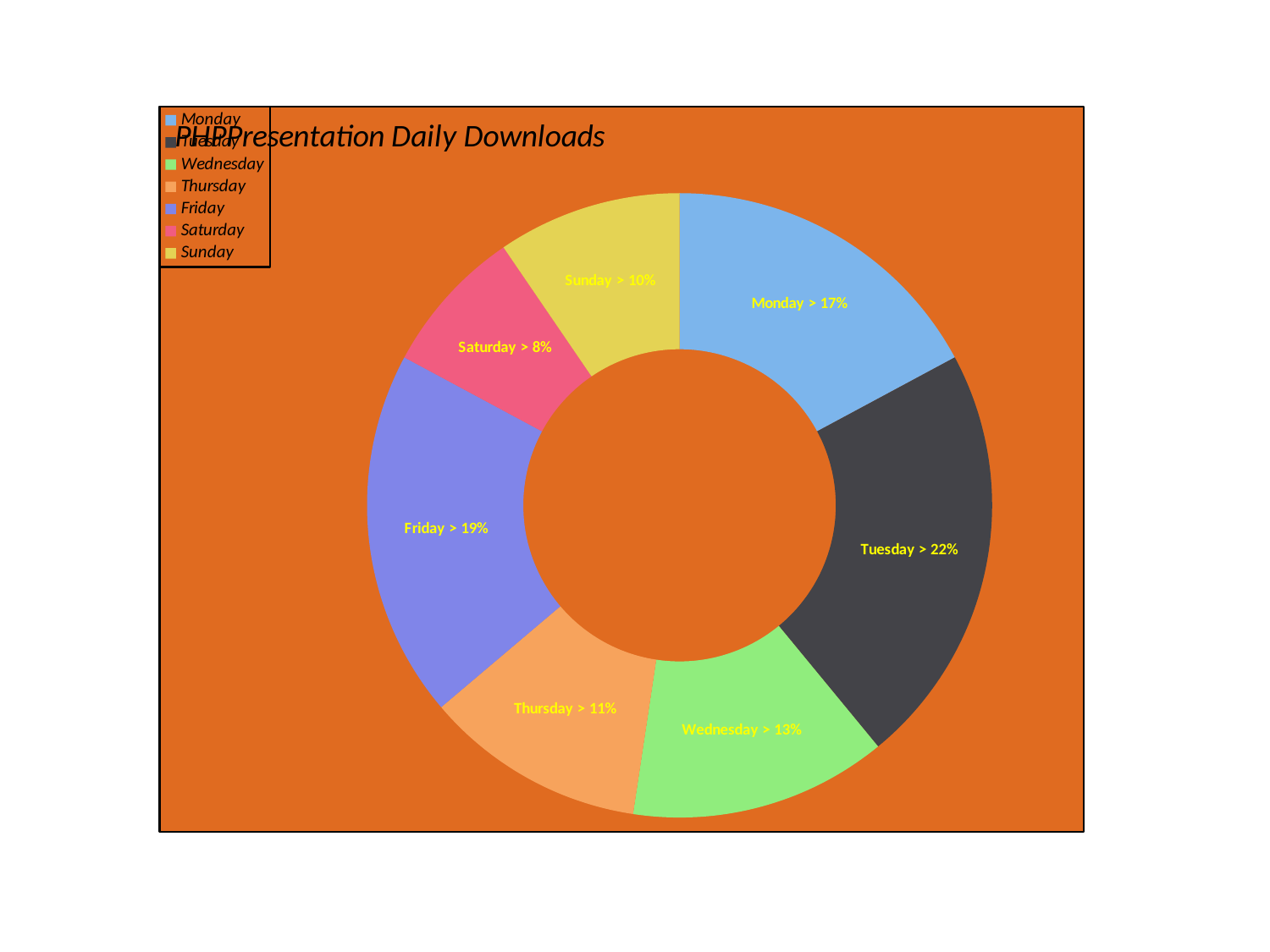
What share of daily downloads does Wednesday account for? 13% What share of daily downloads does Friday account for? 19% How many days are shown in the chart? 7 What share of daily downloads does Saturday account for? 8% Which day has the smallest share of downloads? Saturday What colour is the Friday segment? Purple/blue Which day has the largest share of downloads? Tuesday What is the title of the chart? PHPPresentation Daily Downloads What is the difference in percentage points between Tuesday's and Monday's shares? 5 What kind of chart is shown on the slide? Doughnut (pie) chart Which has a larger share, Thursday or Sunday? Thursday What share of daily downloads does Tuesday account for? 22%